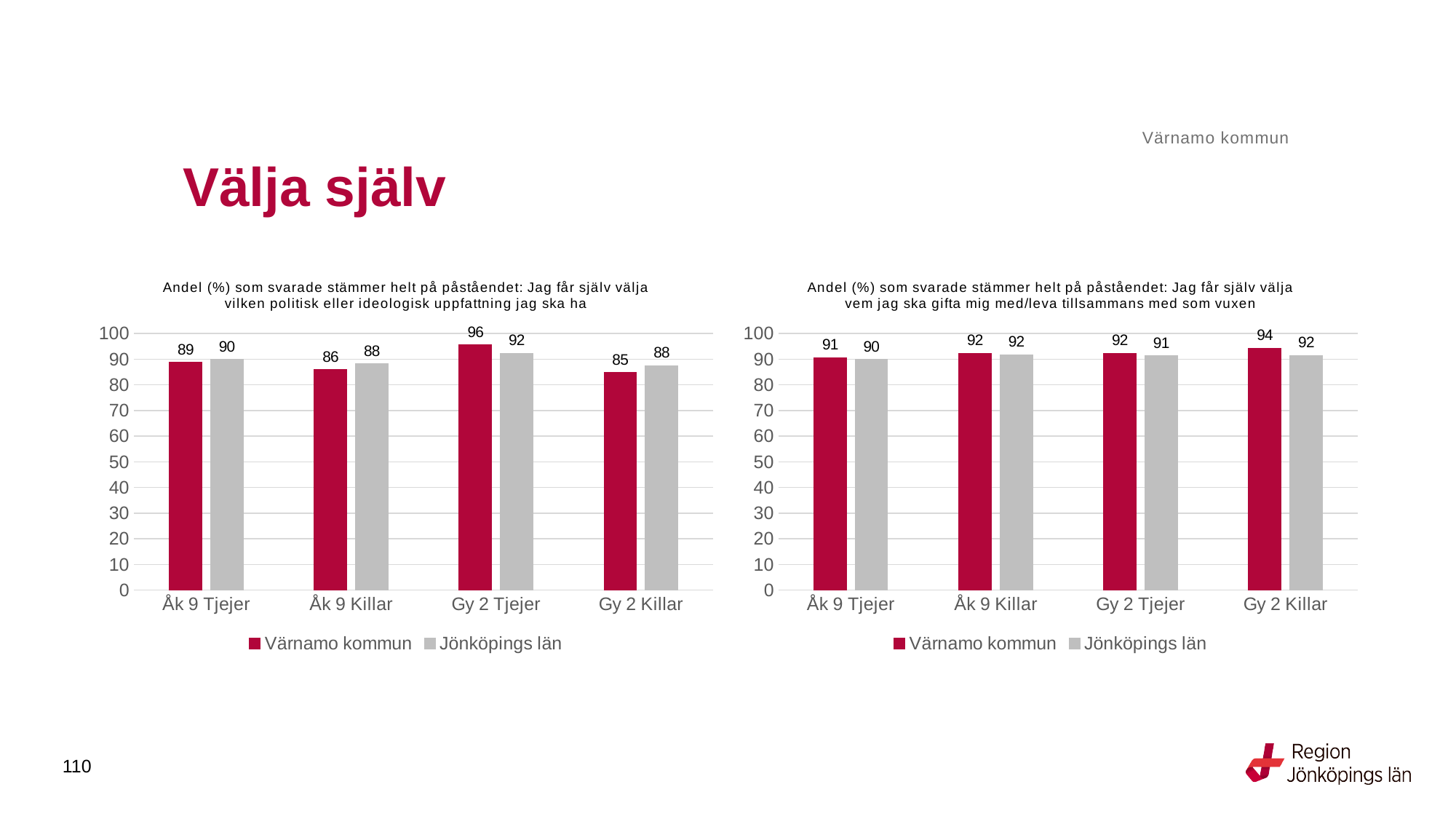
In the right chart (whom to marry/live with), what is the value for Jönköpings län for Åk 9 Tjejer? 90 In the right chart (whom to marry/live with), what is the difference between Värnamo kommun and Jönköpings län for Gy 2 Killar? 2 In the left chart (political or ideological opinion), which is larger for Åk 9 Killar: Värnamo kommun or Jönköpings län? Jönköpings län How many series does the legend of the left chart (political or ideological opinion) list? 2 In the left chart (political or ideological opinion), what is the difference between Värnamo kommun and Jönköpings län for Gy 2 Tjejer? 4 In the right chart (whom to marry/live with), what is the value for Värnamo kommun for Gy 2 Killar? 94 In the left chart (political or ideological opinion), which category has the highest value for Värnamo kommun? Gy 2 Tjejer In the left chart (political or ideological opinion), which category has the lowest value for Värnamo kommun? Gy 2 Killar In the left chart (political or ideological opinion), what is the value for Värnamo kommun for Gy 2 Tjejer? 96 What kind of chart is the right chart (whom to marry/live with)? Bar chart In the left chart (political or ideological opinion), what is the value for Jönköpings län for Åk 9 Killar? 88 How many categories are shown on the x axis of the right chart (whom to marry/live with)? 4